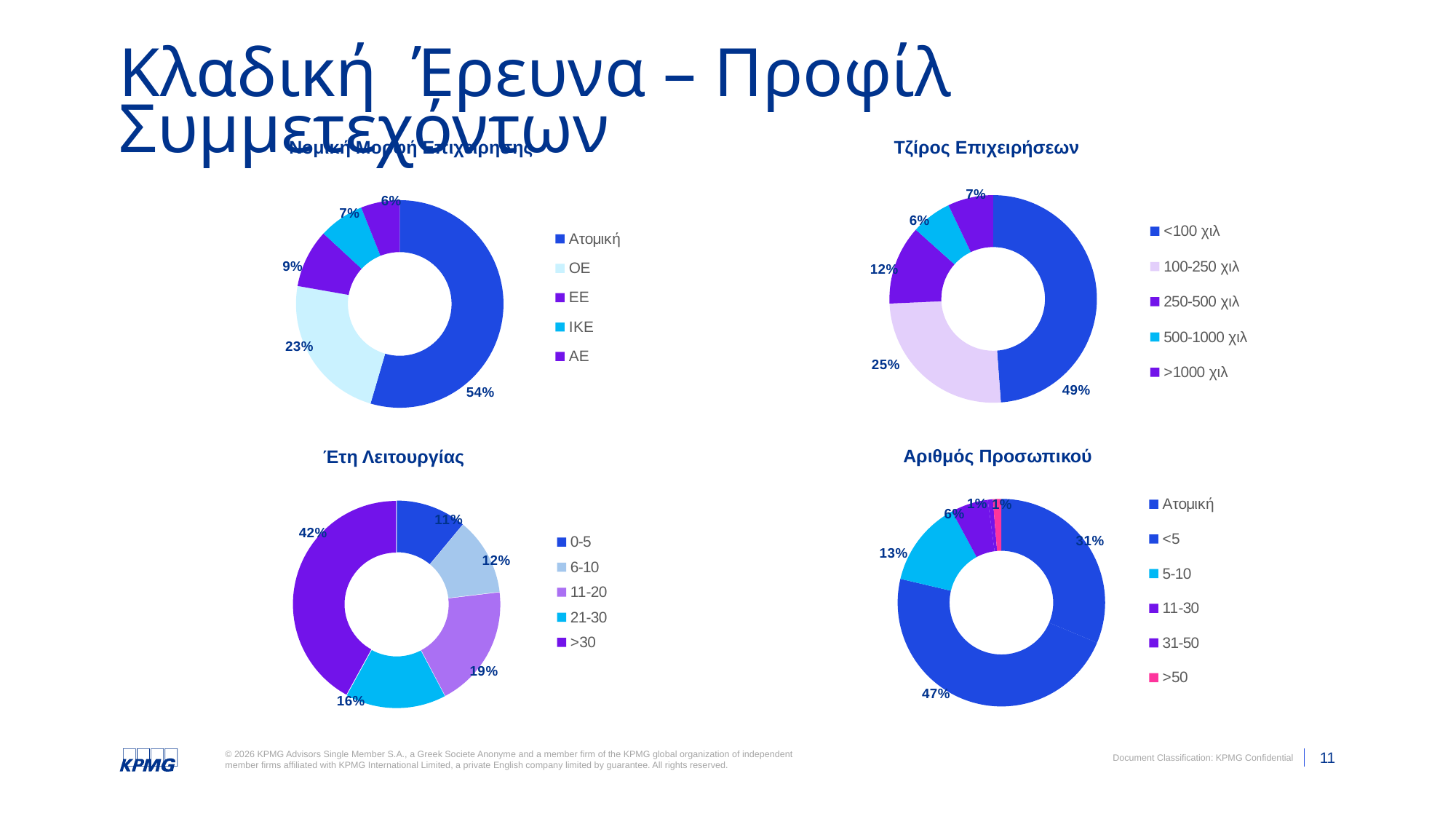
What type of chart is the Αριθμός Προσωπικού chart? Doughnut (pie) chart In the top-left chart (Νομική Μορφή Επιχείρησης), which category has the smallest share? ΑΕ In the Τζίρος Επιχειρήσεων chart, which category has the largest share? <100 χιλ In the top-left chart (Νομική Μορφή Επιχείρησης), what share is Ατομική? 54% In the Έτη Λειτουργίας chart, which category has the smallest share? 0-5 In the Αριθμός Προσωπικού chart, how many categories does the legend list? 6 In the Έτη Λειτουργίας chart, what share is >30? 42% In the top-left chart (Νομική Μορφή Επιχείρησης), how many categories does the legend list? 5 In the Τζίρος Επιχειρήσεων chart, what is the difference between the shares of <100 χιλ and 100-250 χιλ? 24 percentage points In the Αριθμός Προσωπικού chart, what share is <5? 47% In the Τζίρος Επιχειρήσεων chart, what share is 100-250 χιλ? 25% In the Έτη Λειτουργίας chart, which is larger, 11-20 or 21-30? 11-20